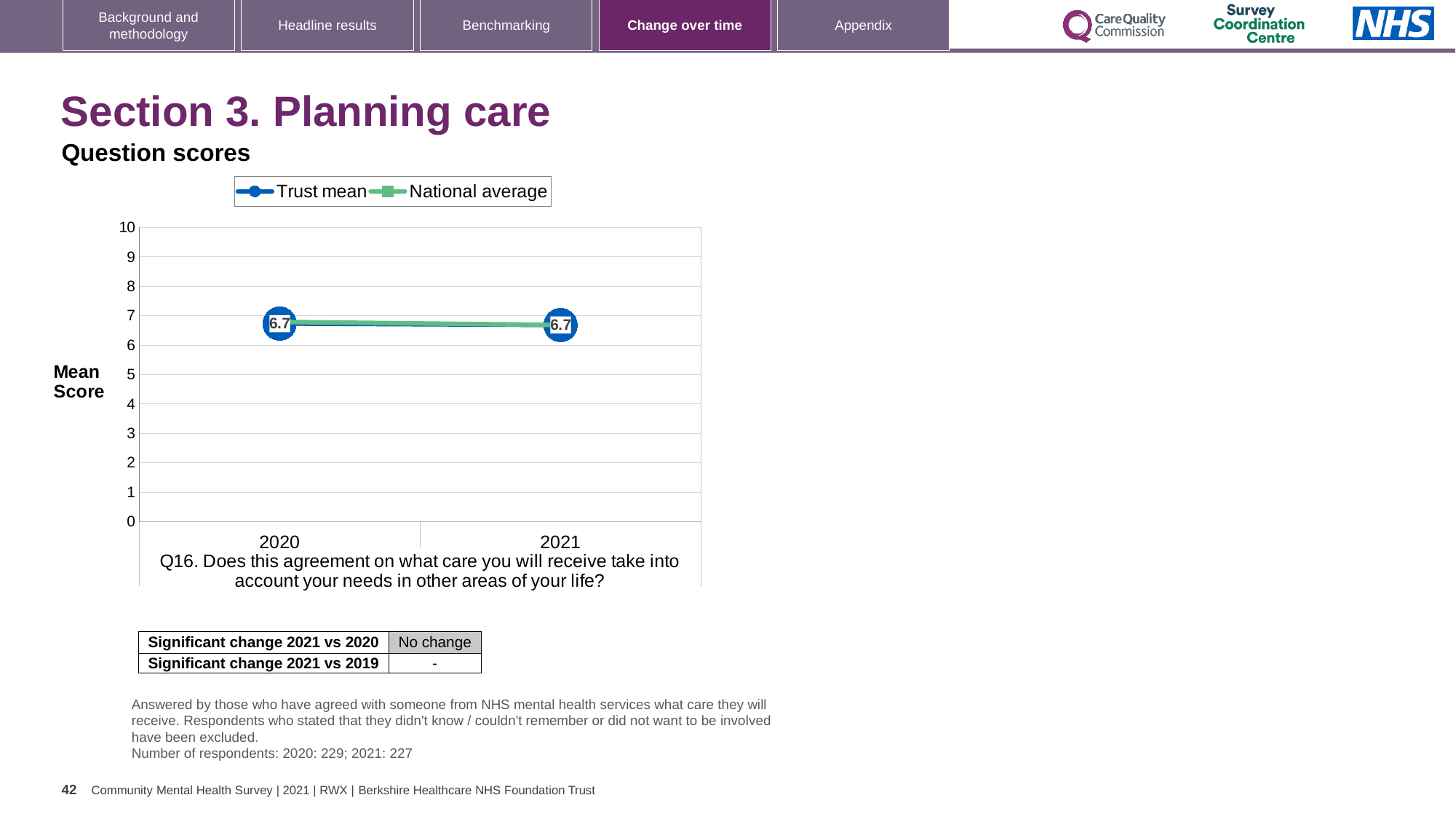
What is the Trust mean value for 2021? 6.7 How many series does the legend list? 2 What are the two series named in the legend? Trust mean and National average Does the Trust mean rise, fall or stay the same from 2020 to 2021? stays the same What is the Trust mean value for 2020? 6.7 Is the Trust mean for 2020 greater or less than 6? greater How many years are plotted on the x axis? 2 What is the label on the y axis of the chart? Mean Score Is the National average value for 2020 greater or less than 8? less What is the difference between the Trust mean in 2021 and the Trust mean in 2020? 0 What kind of chart is shown on the slide? line chart Is the National average value for 2021 greater or less than 5? greater